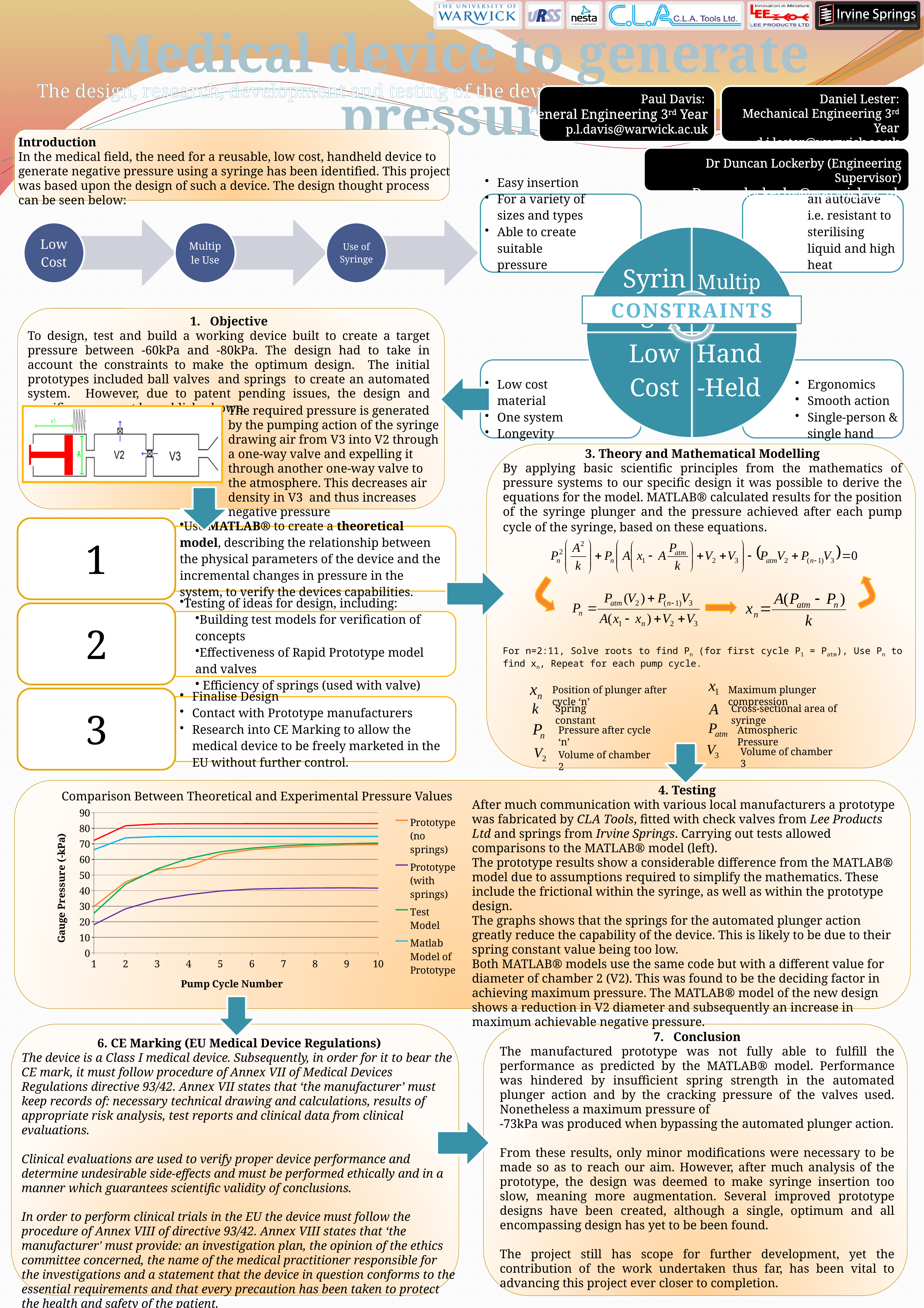
Is the value for Prototype (with springs) at pump cycle 10 greater or less than 50? less Do the values for the Prototype (with springs) series rise or fall as the pump cycle number increases? rise Is the value for Prototype (no springs) at pump cycle 1 greater or less than 20? greater How many pump cycle numbers are shown along the x axis of the chart? 10 What kind of chart is shown on the slide? line chart What is the title of the chart on the slide? Comparison Between Theoretical and Experimental Pressure Values Is the value for Test Model at pump cycle 1 greater or less than 30? less Which legend series has the lowest value at pump cycle 10? Prototype (with springs) At pump cycle 10, which is larger: Prototype (no springs) or Prototype (with springs)? Prototype (no springs) How many series does the chart legend list? 4 What is the label of the y axis of the chart? Gauge Pressure (-kPa)